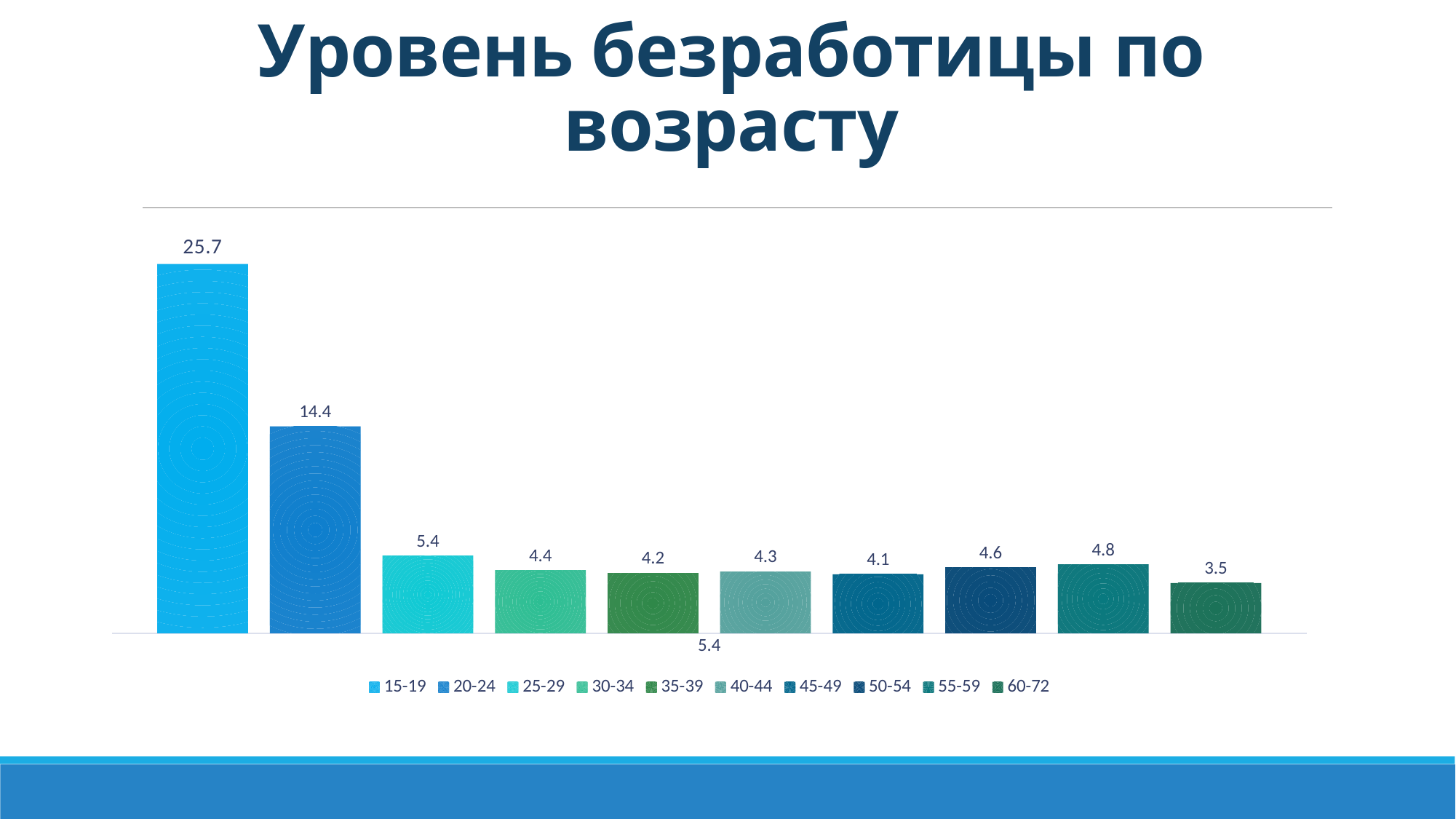
What is the unemployment rate shown for the 15-19 age group? 25.7 What value is shown for the 55-59 age group? 4.8 Which age group has the lowest value on the chart? 60-72 Which has a larger value, the 50-54 age group or the 35-39 age group? 50-54 What is the difference between the values for the 25-29 and 60-72 age groups? 1.9 What type of chart is shown on the slide? Bar chart How many entries does the legend list? 10 What is the difference between the values for the 15-19 and 20-24 age groups? 11.3 What value is shown for the 20-24 age group? 14.4 Which age group has the highest value on the chart? 15-19 What is the title of the chart on the slide? Уровень безработицы по возрасту How many bars are plotted on the chart? 10